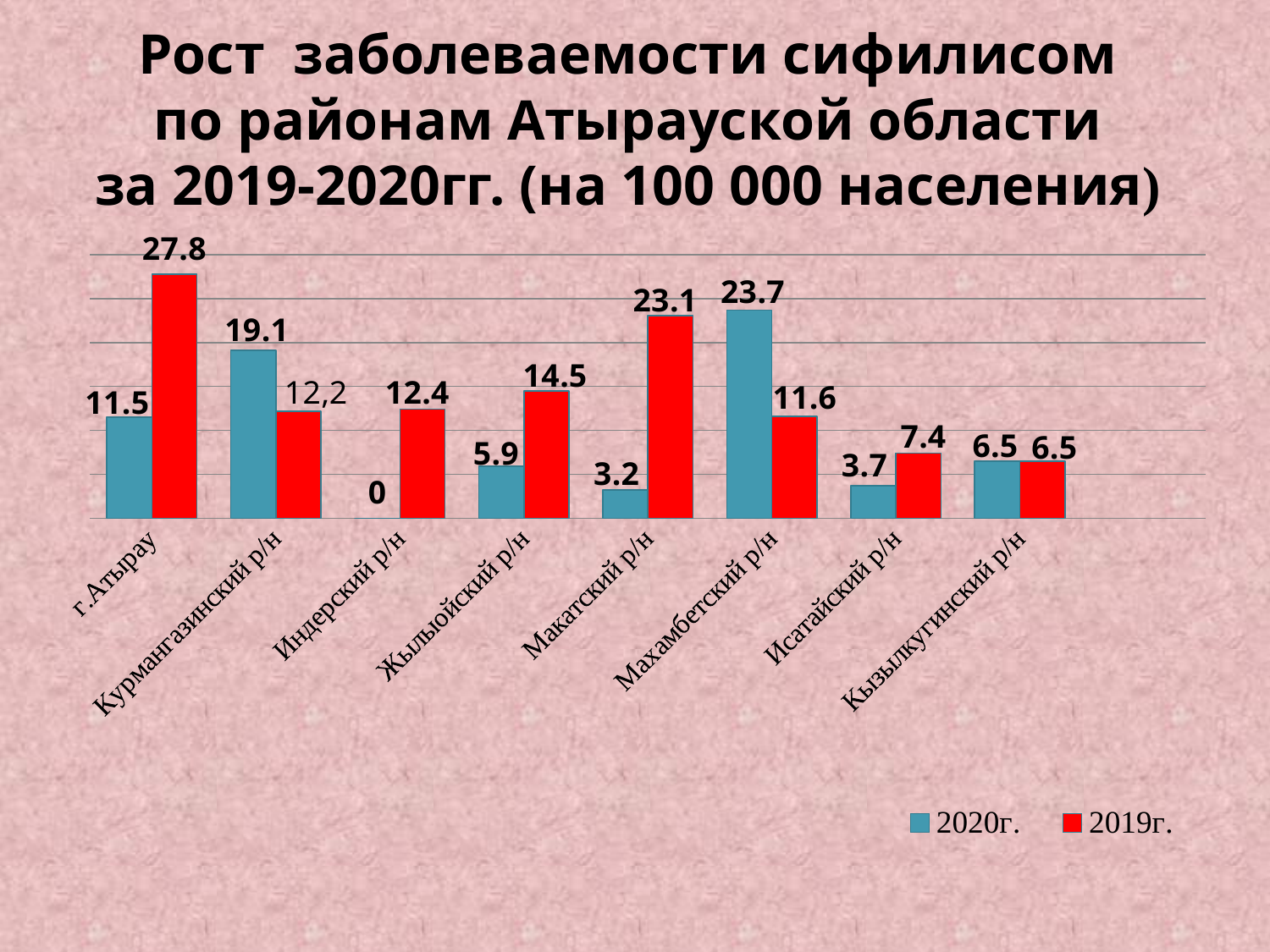
What is the 2019г. value for Макатский р/н? 23.1 What kind of chart is shown on the slide? Bar chart How many districts are shown on the x axis? 8 What is the 2020г. value for г.Атырау? 11.5 What is the difference between the 2019г. and 2020г. values for г.Атырау? 16.3 Which district has the highest 2019г. value? г.Атырау What is the 2019г. value for Курмангазинский р/н? 12,2 Which is larger for Махамбетский р/н, the 2020г. value or the 2019г. value? 2020г. What is the 2020г. value for Индерский р/н? 0 Which district has the highest 2020г. value? Махамбетский р/н How many series does the legend list? 2 Which district has the lowest 2020г. value? Индерский р/н